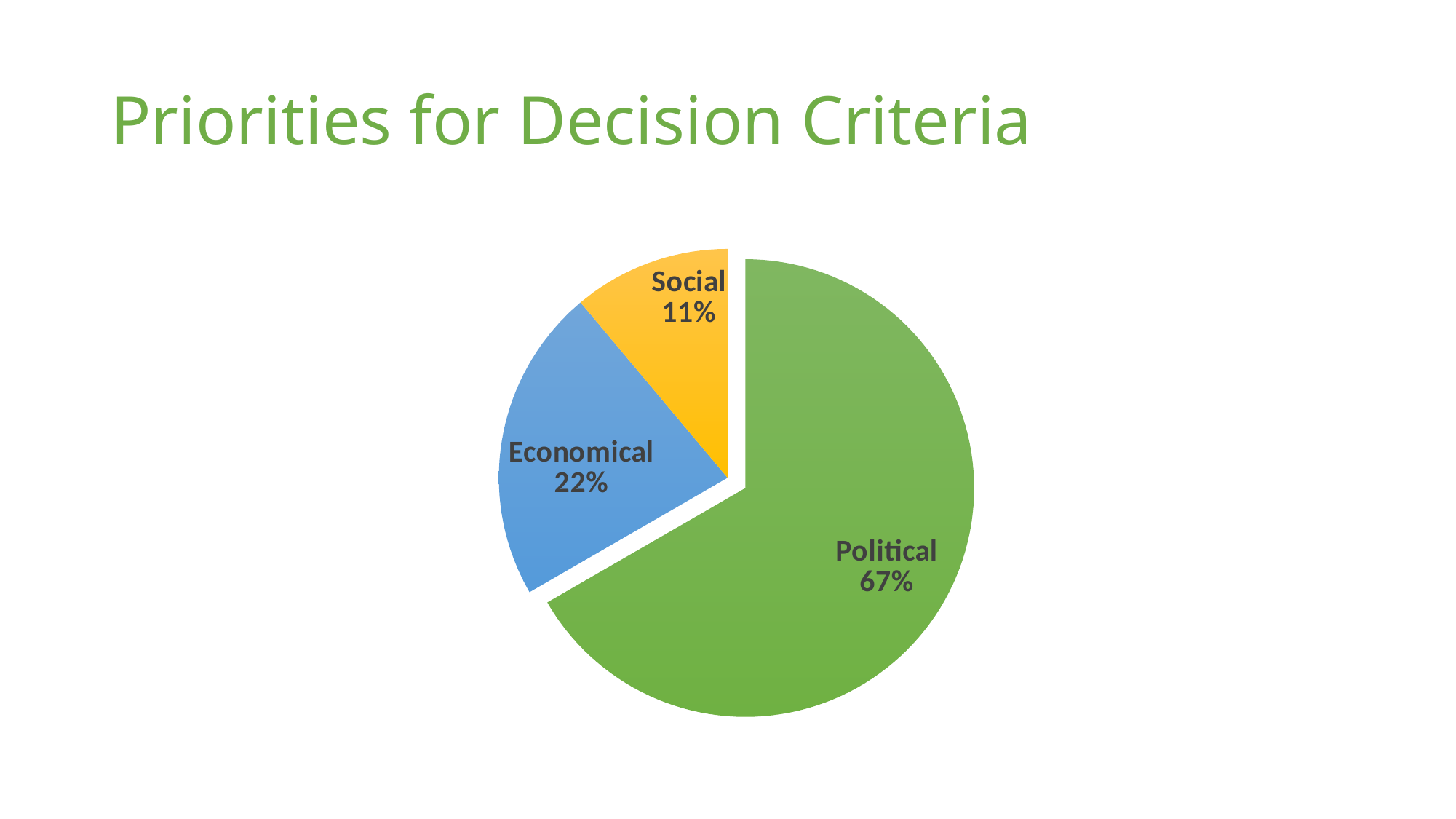
What colour is the Political slice? Green Which category has the smallest slice of the pie? Social What kind of chart is shown on the slide? Pie chart Which category has the largest slice of the pie? Political What is the title of the slide? Priorities for Decision Criteria Which is larger, the Economical slice or the Social slice? Economical What is the difference between the Political and Economical shares? 45% What share of the pie does the Political slice represent? 67% What is the difference between the Economical and Social shares? 11% How many categories are shown in the pie chart? 3 What is the value shown for the Social slice? 11% What is the value shown for the Economical slice? 22%